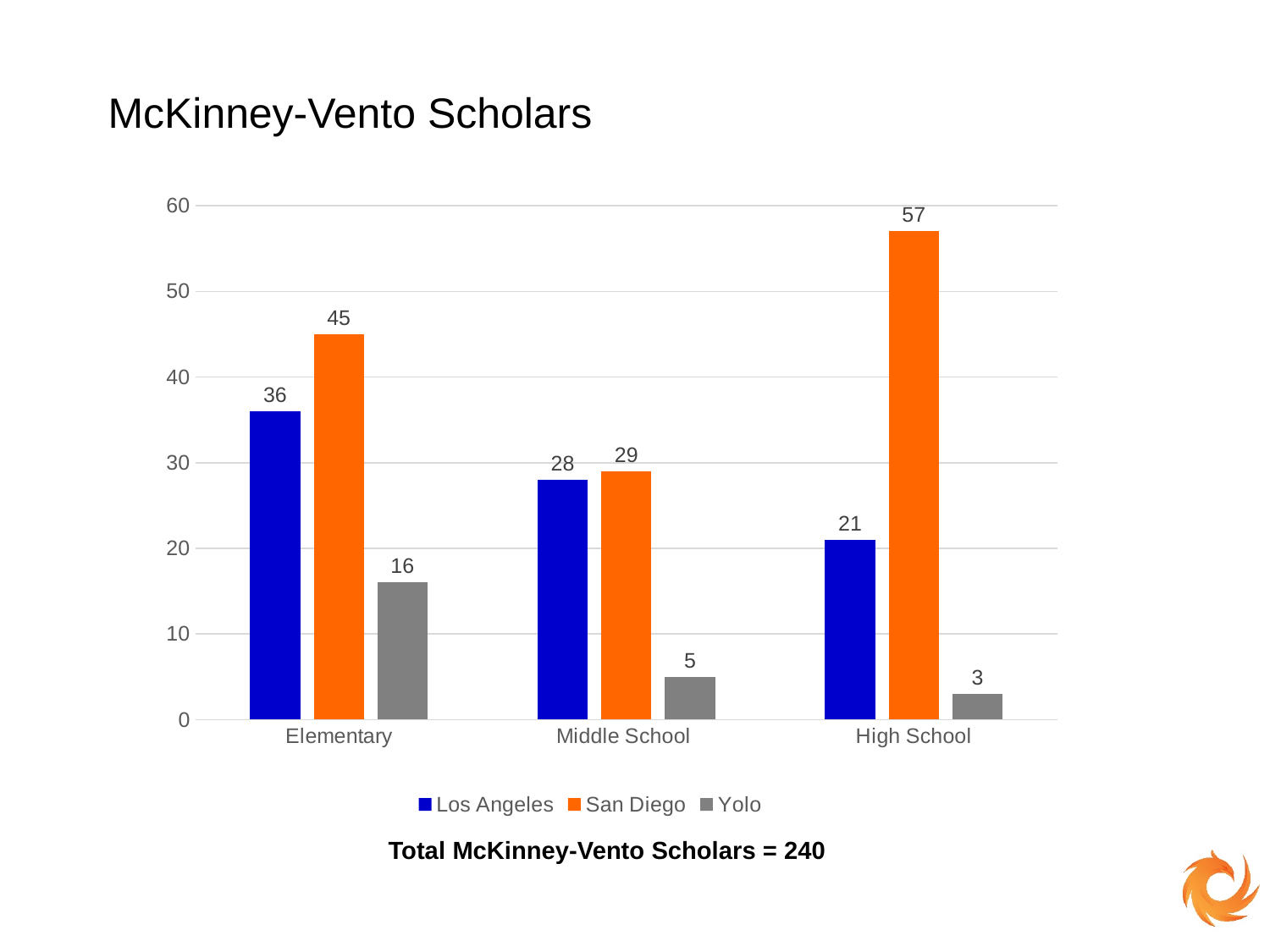
Is the value for Los Angeles in the Elementary category greater or less than 30? greater Which category has the lowest value for Yolo? High School What is the difference between the San Diego and Los Angeles values in the High School category? 36 Which category has the highest value for San Diego? High School What is the value for Yolo in the Elementary category? 16 How many series does the legend list? 3 Which is larger in the Elementary category, Los Angeles or San Diego? San Diego Do the Los Angeles values rise or fall from Elementary to High School? Fall What is the value for Los Angeles in the Middle School category? 28 What is the value for San Diego in the High School category? 57 How many categories are shown on the x axis? 3 What kind of chart is shown on the slide? Bar chart